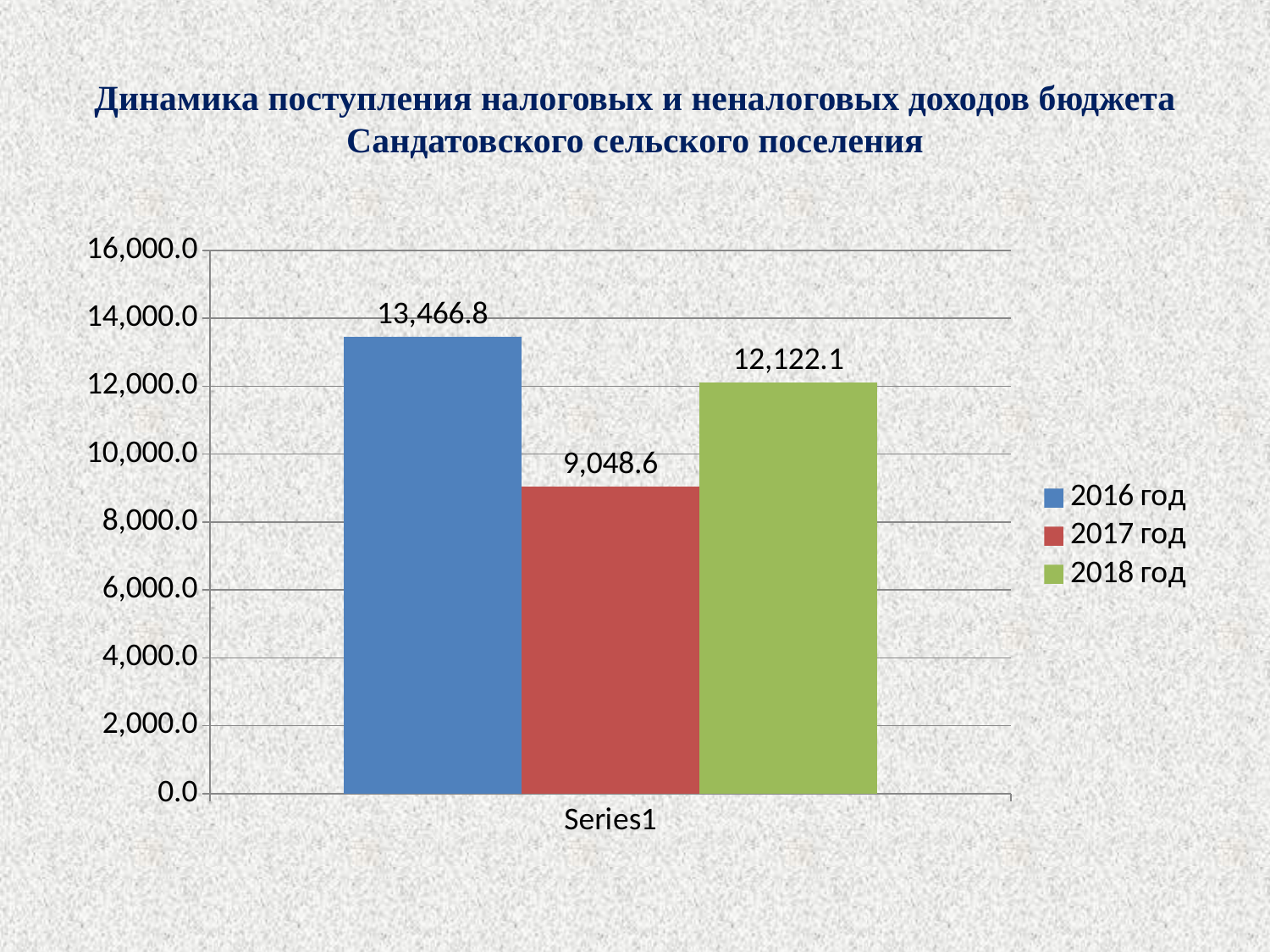
What colour is the bar for 2018 год? green What is the value for 2016 год? 13,466.8 What is the value for 2018 год? 12,122.1 What kind of chart is shown on the slide? bar chart Is the value for 2017 год greater or less than 10,000.0? less How many series does the legend list? 3 What is the value for 2017 год? 9,048.6 Which is larger, the value for 2016 год or the value for 2018 год? 2016 год Which year has the lowest value? 2017 год What is the difference between the values for 2018 год and 2017 год? 3,073.5 What is the difference between the values for 2016 год and 2017 год? 4,418.2 Which year has the highest value? 2016 год